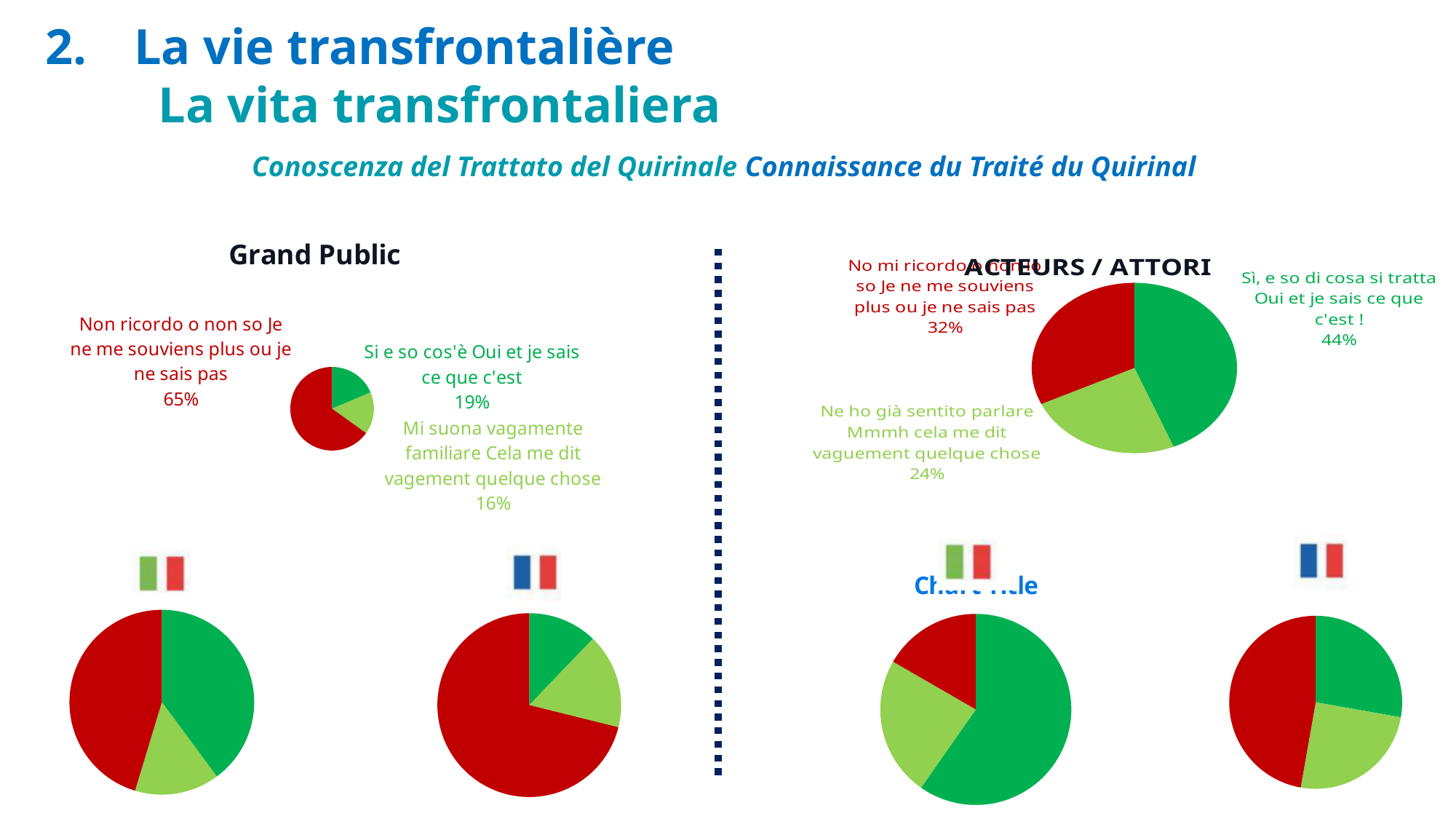
In the Grand Public pie chart, which category has the largest share? Non ricordo o non so / Je ne me souviens plus ou je ne sais pas In the Grand Public pie chart, what share is labelled "Mi suona vagamente familiare / Cela me dit vaguement quelque chose"? 16% In the Grand Public pie chart, what share is labelled "Si e so cos'è / Oui et je sais ce que c'est"? 19% In the ACTEURS / ATTORI pie chart, what share is labelled "Ne ho già sentito parlare / Mmmh cela me dit vaguement quelque chose"? 24% In the ACTEURS / ATTORI pie chart, which category has the smallest share? Ne ho già sentito parlare / Mmmh cela me dit vaguement quelque chose What type of chart is used for the Grand Public data? Pie chart In the ACTEURS / ATTORI pie chart, what share is labelled "No mi ricordo o non so / Je ne me souviens plus ou je ne sais pas"? 32% Which is larger: the "Oui et je sais ce que c'est" share in the Grand Public pie chart or in the ACTEURS / ATTORI pie chart? ACTEURS / ATTORI In the Grand Public pie chart, what share is labelled "Non ricordo o non so / Je ne me souviens plus ou je ne sais pas"? 65% How many slices does the Grand Public pie chart have? 3 In the ACTEURS / ATTORI pie chart, what share is labelled "Sì, e so di cosa si tratta / Oui et je sais ce que c'est !"? 44% What is the difference in percentage points between the "Non ricordo o non so" share in the Grand Public pie chart and the "No mi ricordo o non so" share in the ACTEURS / ATTORI pie chart? 33 percentage points